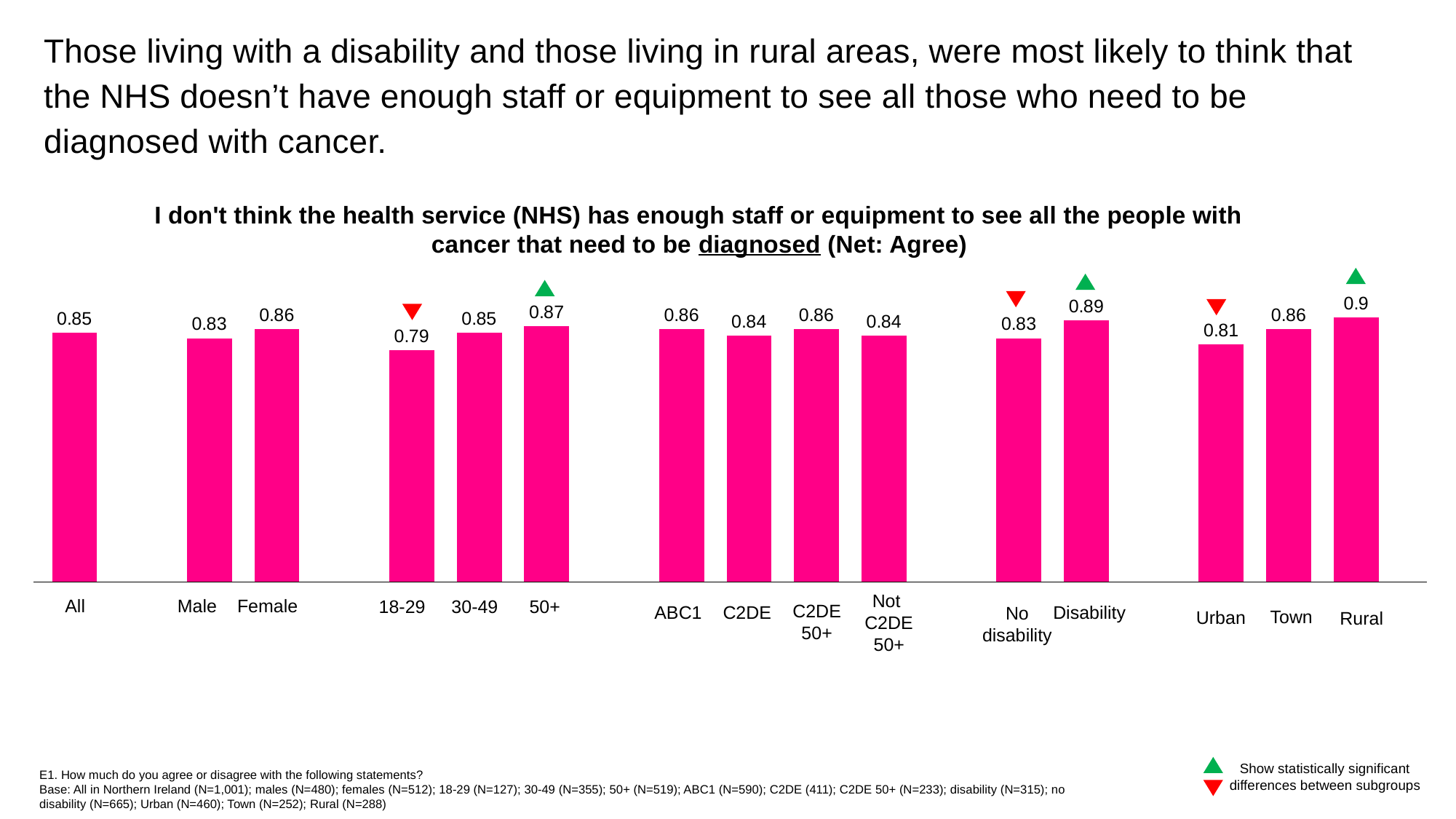
What is the difference between the values for Disability and No disability? 0.06 Which is larger, the value for Female or the value for Male? Female What is the value for Disability? 0.89 What kind of chart is shown on the slide? Bar chart Which category has the highest value? Rural What is the value for 18-29? 0.79 How many categories are shown on the chart? 15 Do the values rise or fall across the age groups from 18-29 to 50+? Rise What is the difference between the values for Rural and Urban? 0.09 What is the value for Rural? 0.9 What is the value for All? 0.85 Which category has the lowest value? 18-29